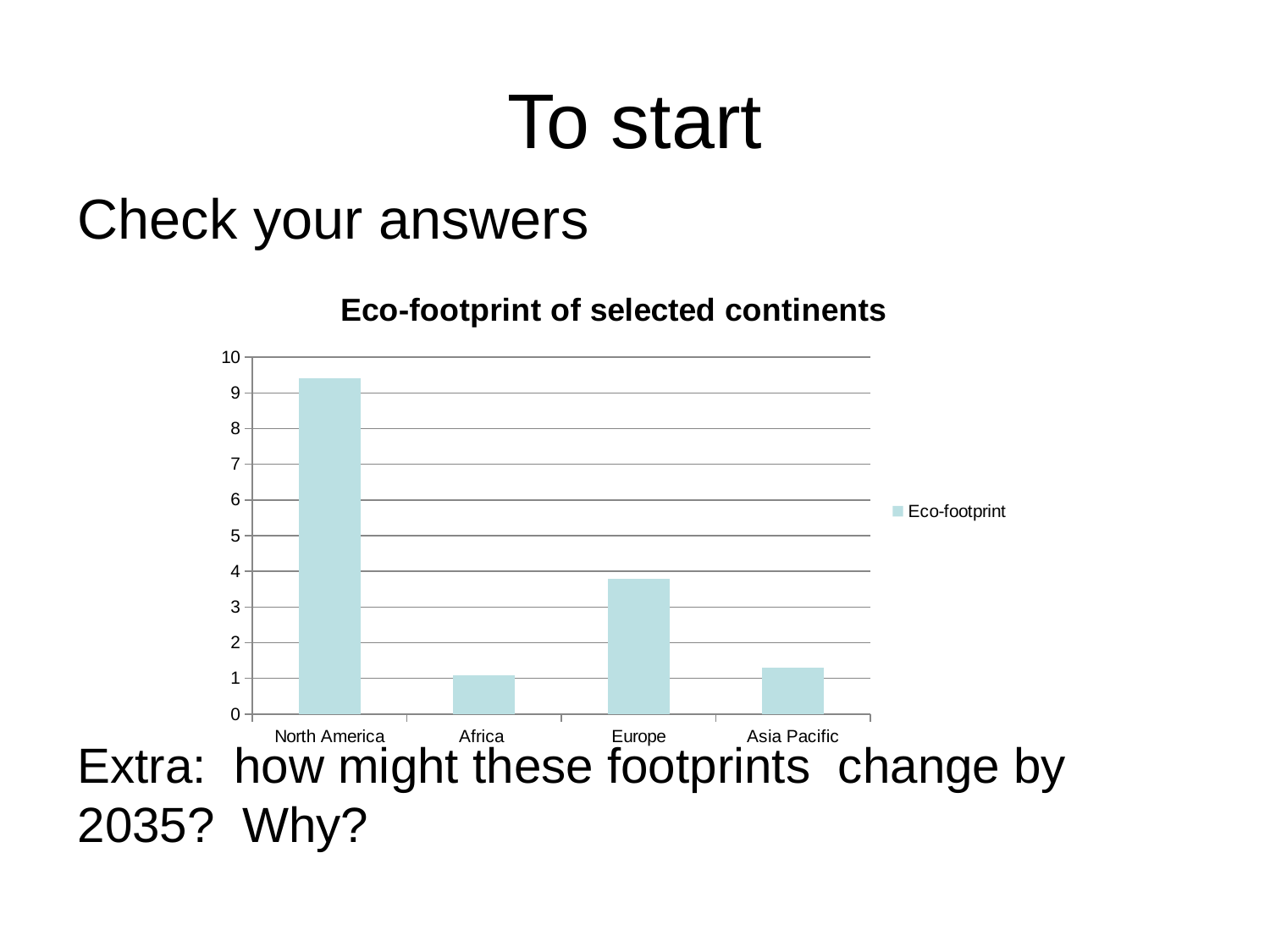
Is the eco-footprint value for Asia Pacific greater or less than 1? greater Which has the larger eco-footprint, Europe or Asia Pacific? Europe Is the eco-footprint value for North America greater or less than 9? greater Is the eco-footprint value for Africa greater or less than 2? less What is the title of the chart? Eco-footprint of selected continents Which has the larger eco-footprint, North America or Europe? North America What is the name of the series shown in the legend? Eco-footprint Which continent has the highest eco-footprint in the chart? North America What kind of chart is shown on the slide? bar chart How many continents are shown on the x axis of the chart? 4 How many series does the legend list? 1